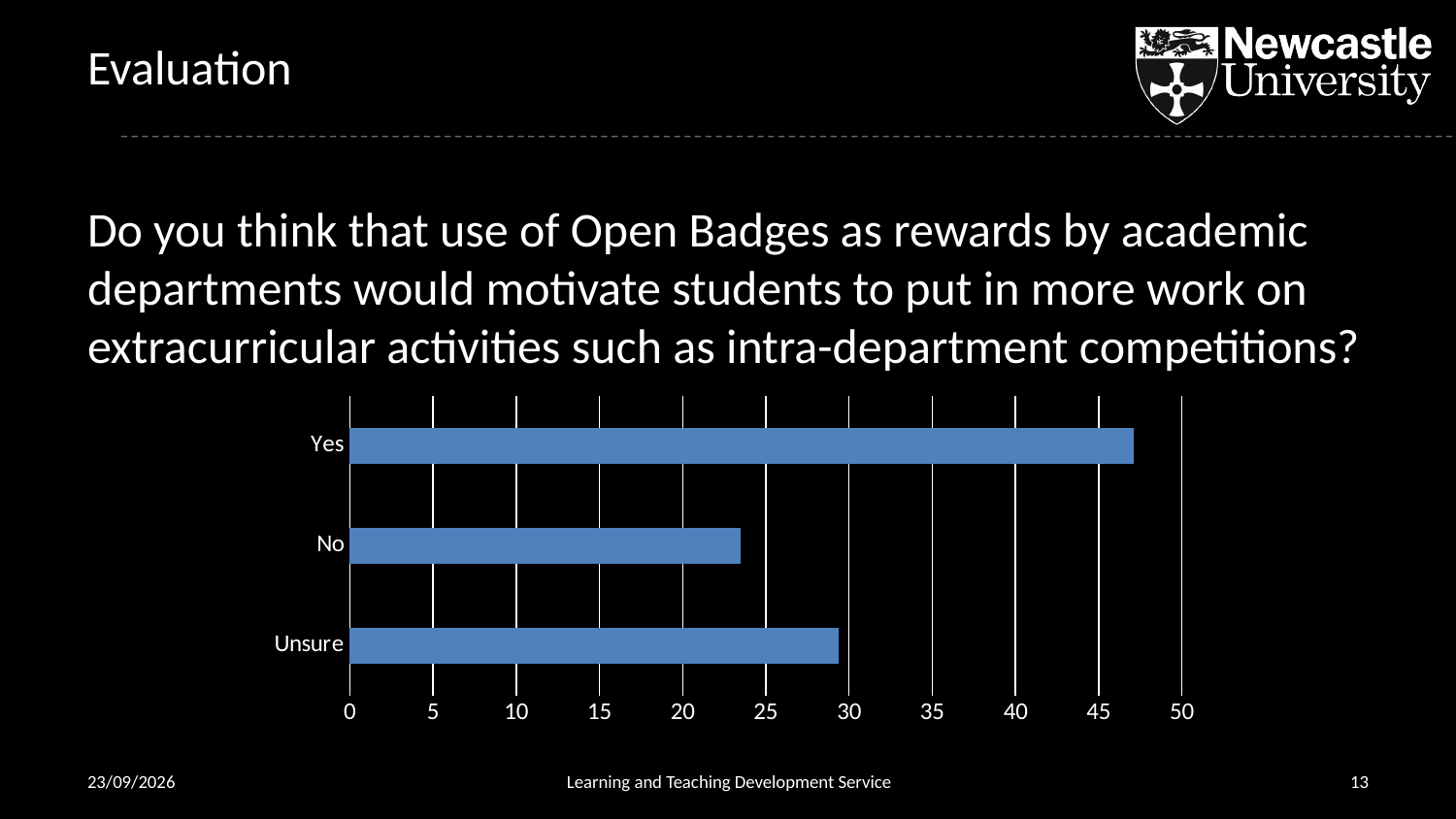
Is the value for No greater or less than 25? less What kind of chart is shown on the slide? bar chart Which is larger, the value for Yes or the value for Unsure? Yes How many categories are plotted in the chart? 3 What is the highest value shown on the chart's horizontal axis? 50 Is the value for Yes greater or less than 45? greater Which category has the lowest value in the chart? No Which category has the highest value in the chart? Yes Which is larger, the value for Unsure or the value for No? Unsure Is the value for No greater or less than 20? greater What colour are the bars in the chart? blue